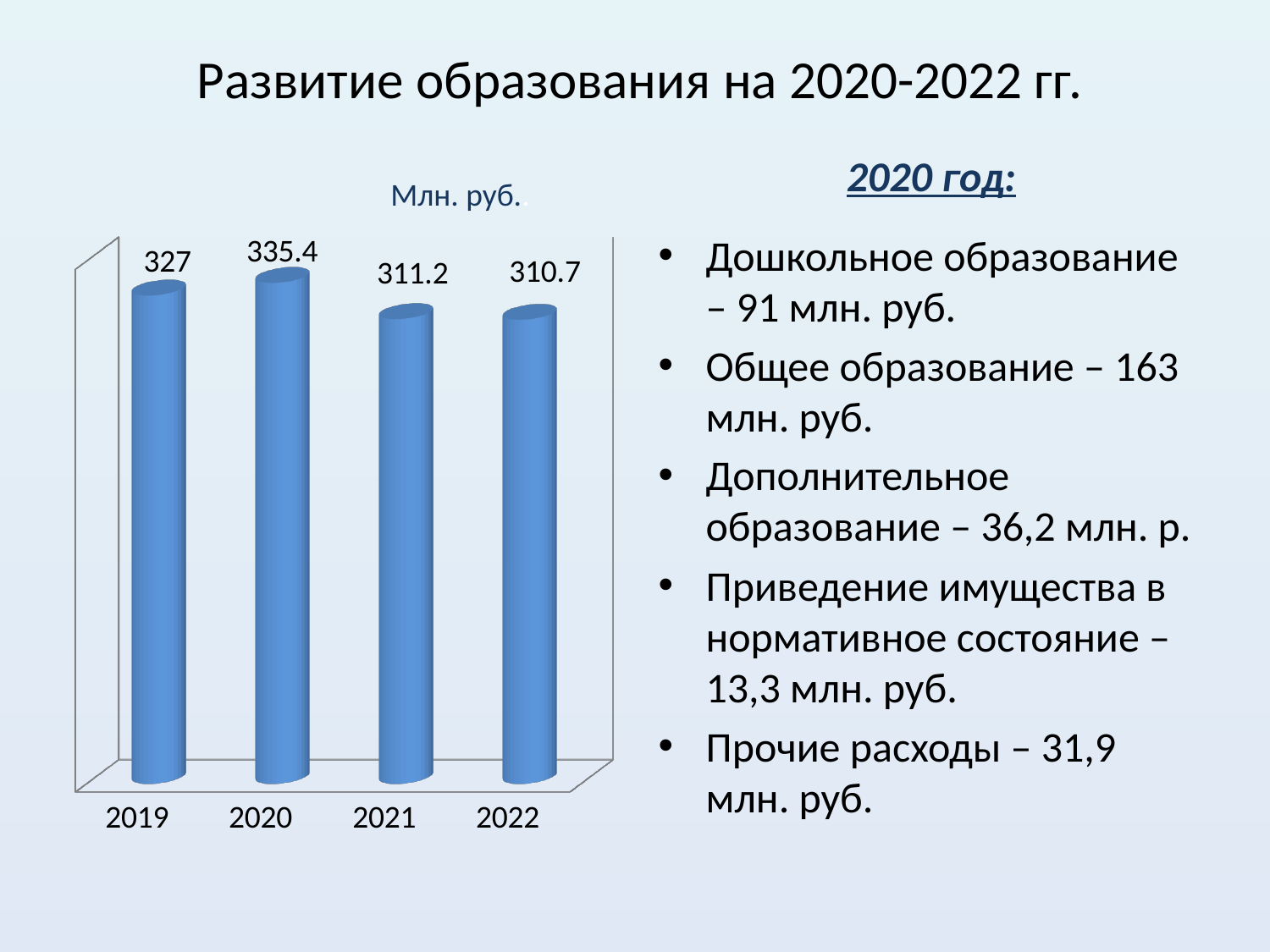
What is the difference between the values for 2020 and 2019? 8.4 What is the difference between the values for 2020 and 2021? 24.2 Which year has the highest value in the chart? 2020 What is the value for 2019 in the chart? 327 Which is larger, the value for 2019 or the value for 2021? 2019 What is the value for 2021 in the chart? 311.2 What is the value for 2020 in the chart? 335.4 What is the value for 2022 in the chart? 310.7 Which year has the lowest value in the chart? 2022 What is the title of the chart? Млн. руб. What kind of chart is shown on the slide? bar chart How many years are shown on the x axis of the chart? 4